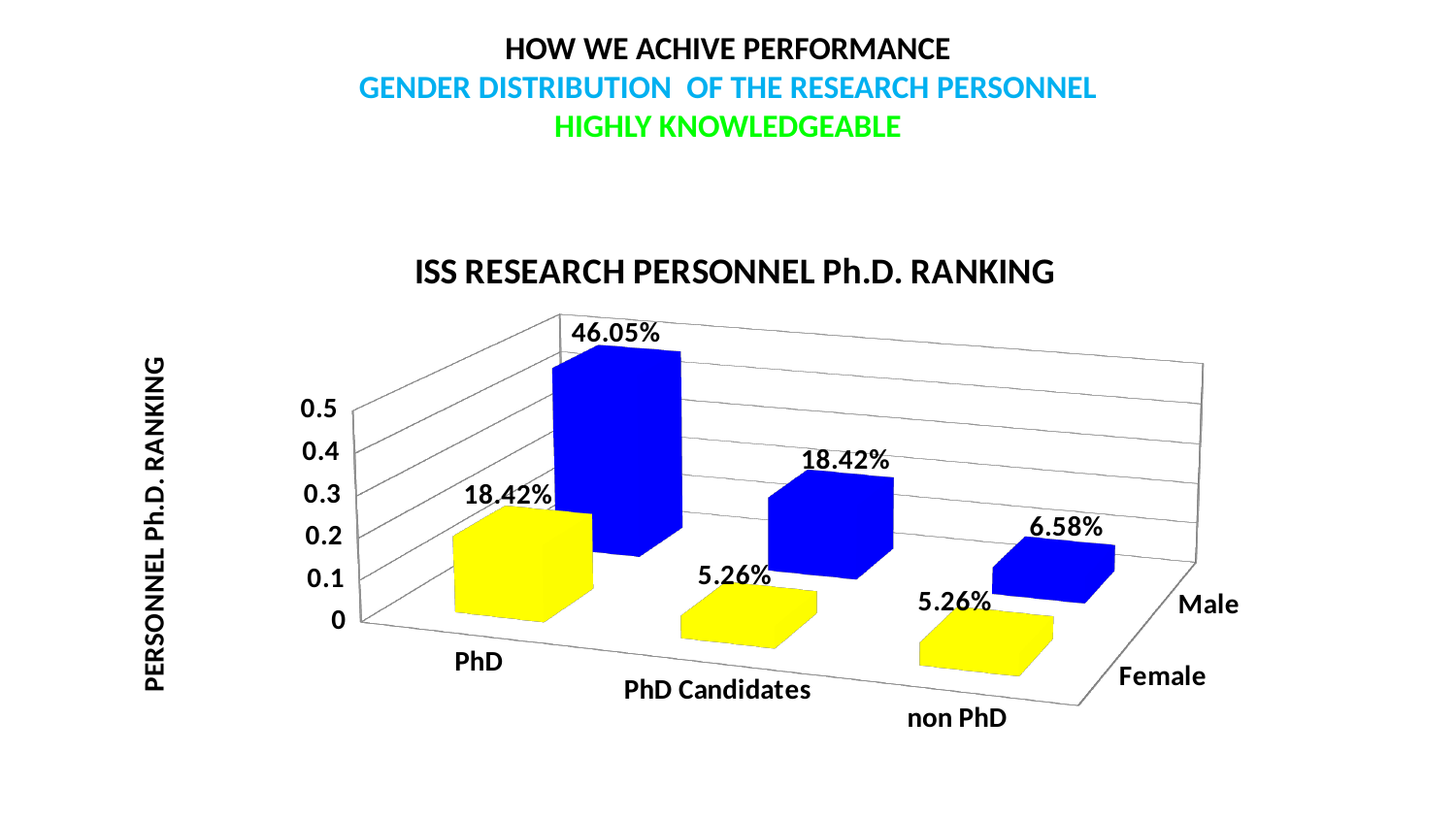
Which category has the highest Male value? PhD How many categories are shown on the x axis? 3 What is the value for Female in the PhD category? 18.42% What is the value for Male in the non PhD category? 6.58% What is the difference between the Male and Female values in the PhD category? 27.63% What is the value for Male in the PhD category? 46.05% Which is larger in the PhD Candidates category, the Male value or the Female value? Male What is the value for Male in the PhD Candidates category? 18.42% What is the title of the chart? ISS RESEARCH PERSONNEL Ph.D. RANKING What is the value for Female in the non PhD category? 5.26% What kind of chart is shown? Bar chart Which category has the lowest Male value? non PhD